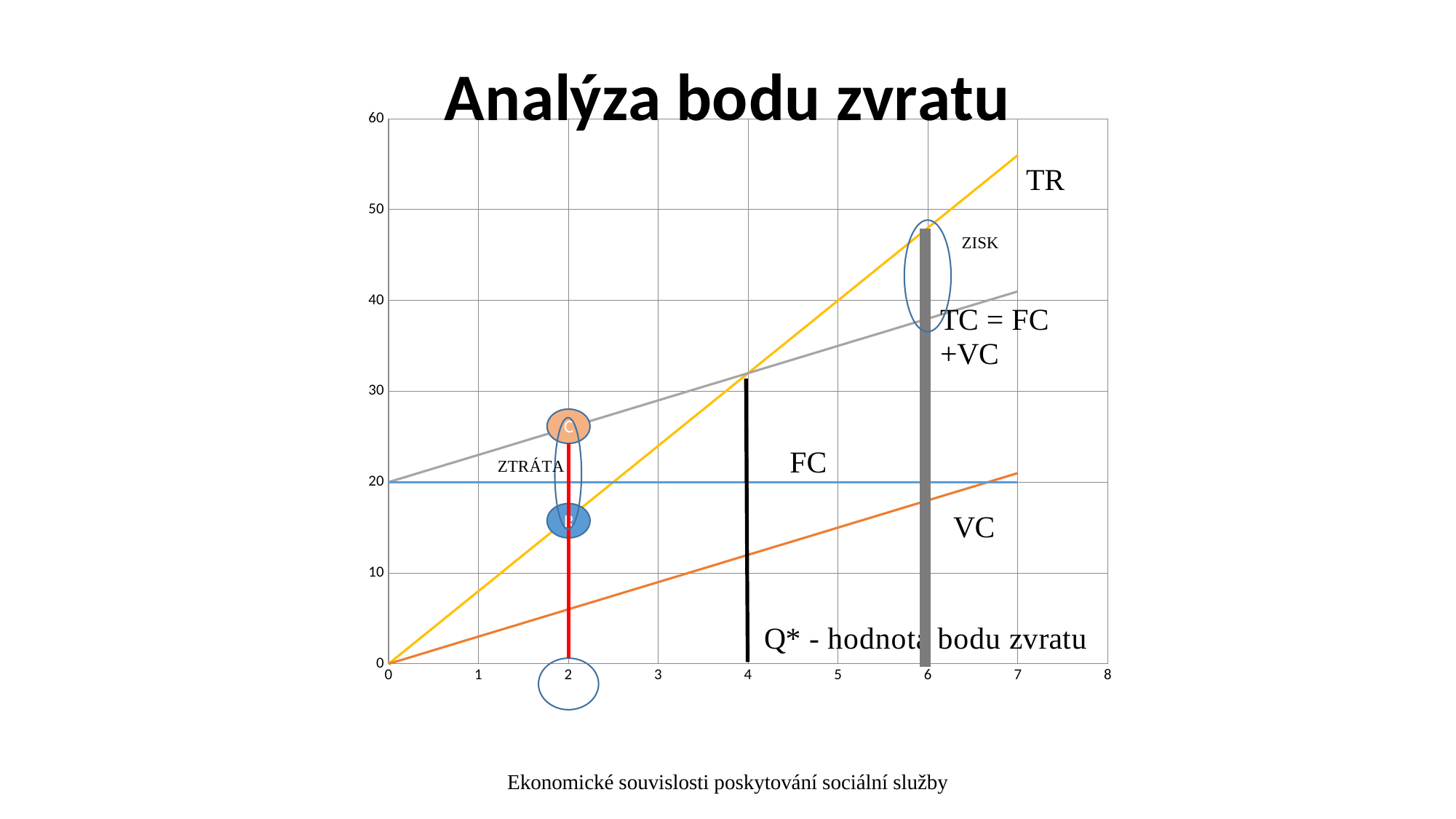
At what value on the vertical axis does the horizontal FC line lie? 20 Is the value of the TC line at x = 2 greater or less than 20? greater What kind of chart is shown on the slide? line chart Which line has the highest value at x = 7? TR What is the title of the chart? Analýza bodu zvratu At which x-axis value is Q* (the break-even point) marked by the black vertical line? 4 Is the value of the VC line at x = 4 greater or less than 20? less At x = 6, which line is higher, TR or TC? TR At x = 2, which line is higher, TR or TC? TC Does the TR line rise or fall as x increases? rise Which line has the lowest value at x = 4? VC Is the value of the TR line at x = 7 greater or less than 50? greater